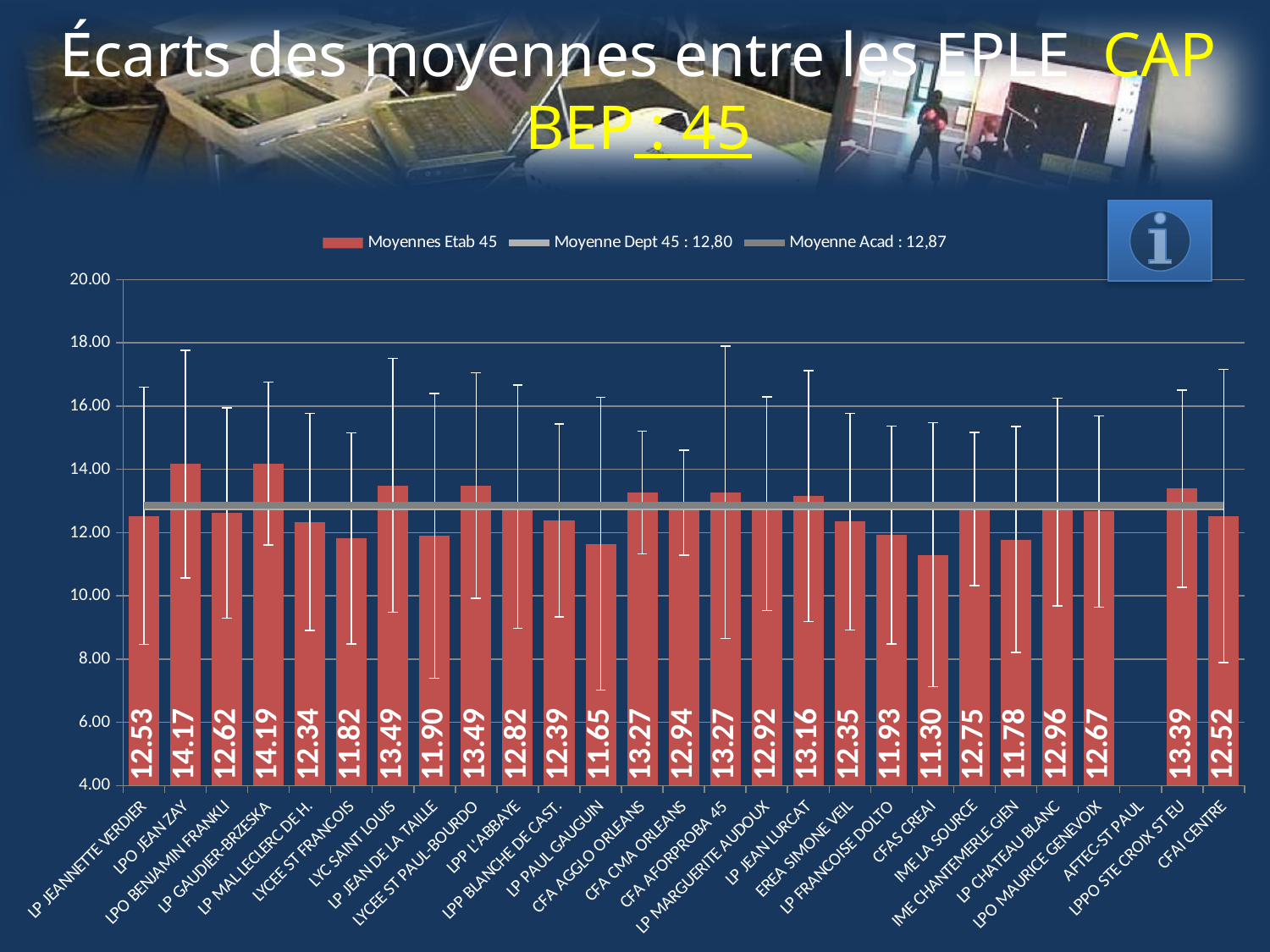
Which is larger, the value for LYC SAINT LOUIS or the value for LP JEAN LURCAT? LYC SAINT LOUIS Is the value for CFAS CREAI greater or less than 12.00? less What is the value for LPPO STE CROIX ST EU? 13.39 What is the value for LP JEAN LURCAT? 13.16 How many series does the legend list? 3 What is the difference between the values for LPO JEAN ZAY and LYCEE ST FRANCOIS? 2.35 What is the value for CFAS CREAI? 11.30 Which establishment has the highest value? LP GAUDIER-BRZESKA What kind of chart is shown on the slide? bar chart What is the value for LPO JEAN ZAY? 14.17 According to the legend, what is the value of Moyenne Dept 45? 12,80 Which establishment has the lowest value? CFAS CREAI